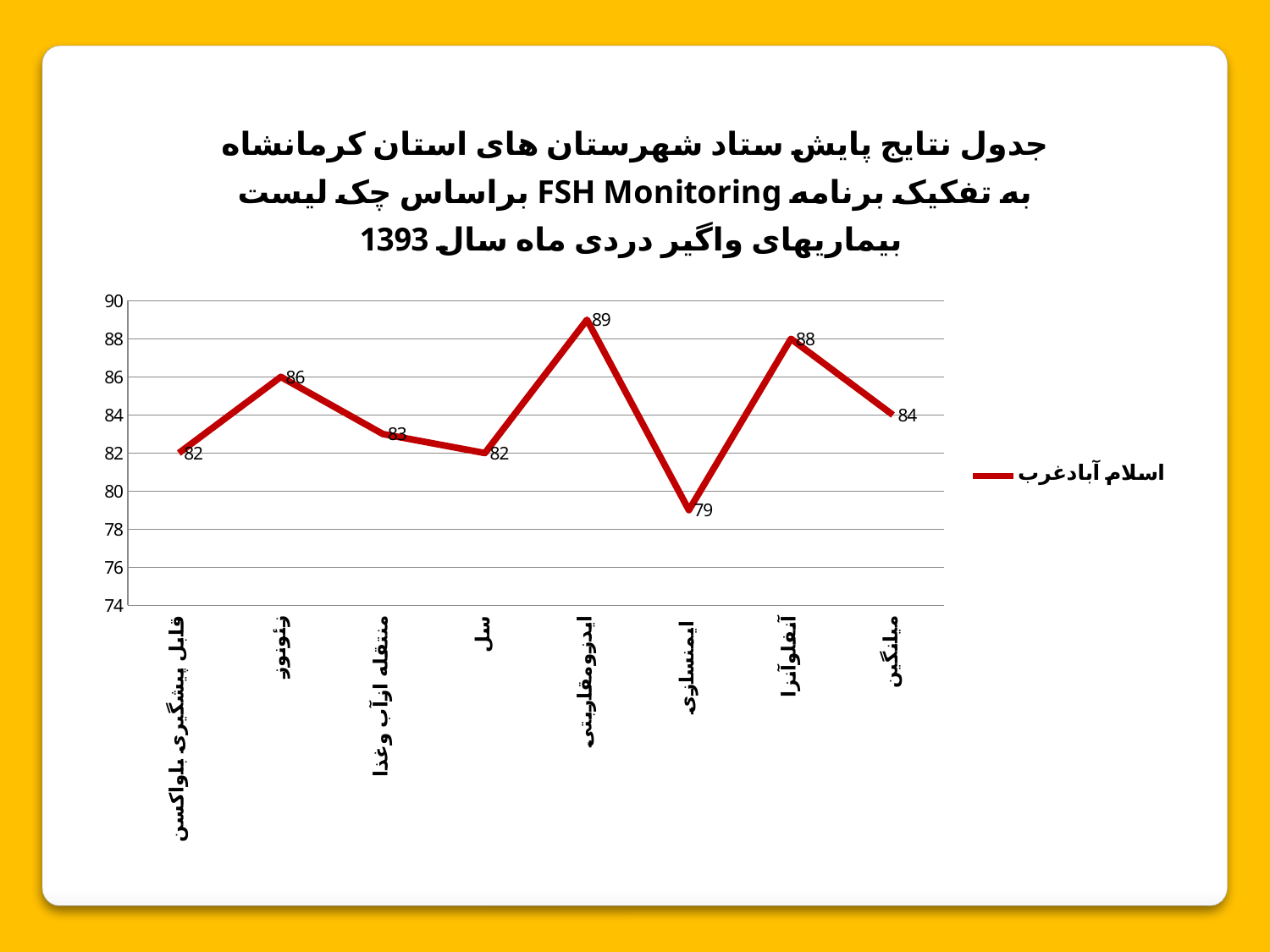
What is the name of the series shown in the legend? اسلام آبادغرب What is the value for میانگین? 84 What is the difference between the values for آنفلوآنزا and ایمنسازی? 9 What is the value for ایدز و مقاربتی? 89 What type of chart is shown on the slide? line chart What is the value for زئونوز? 86 Which category has the lowest value? ایمنسازی How many categories are plotted on the x axis? 8 Which is larger, the value for زئونوز or the value for منتقله از آب و غذا? زئونوز How many series does the legend list? 1 What is the value for ایمنسازی? 79 Which category has the highest value? ایدز و مقاربتی